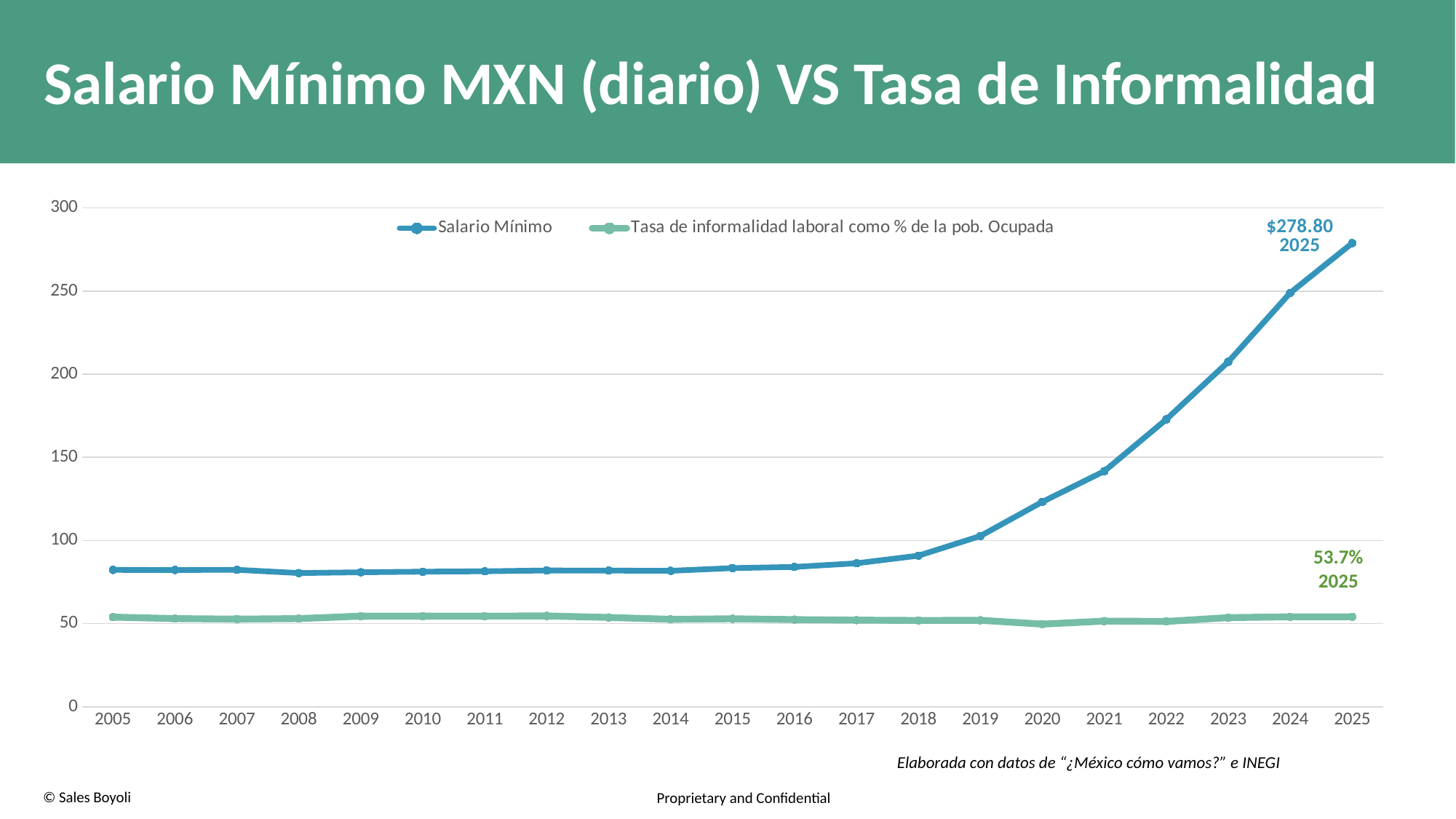
Is the Salario Mínimo value for 2023 greater or less than 200? greater How many series does the legend list? 2 Does the Salario Mínimo series rise or fall from 2018 to 2025? rise In which year is the Salario Mínimo highest? 2025 What kind of chart is shown on the slide? line chart What is the title of the chart? Salario Mínimo MXN (diario) VS Tasa de Informalidad What is the value of Tasa de informalidad laboral como % de la pob. Ocupada in 2025? 53.7% What is the value of Salario Mínimo in 2025? $278.80 Which is larger in 2025, Salario Mínimo or Tasa de informalidad laboral como % de la pob. Ocupada? Salario Mínimo Is the Salario Mínimo value for 2015 greater or less than 100? less How many years are shown on the x axis? 21 Is the Salario Mínimo value for 2021 greater or less than 100? greater